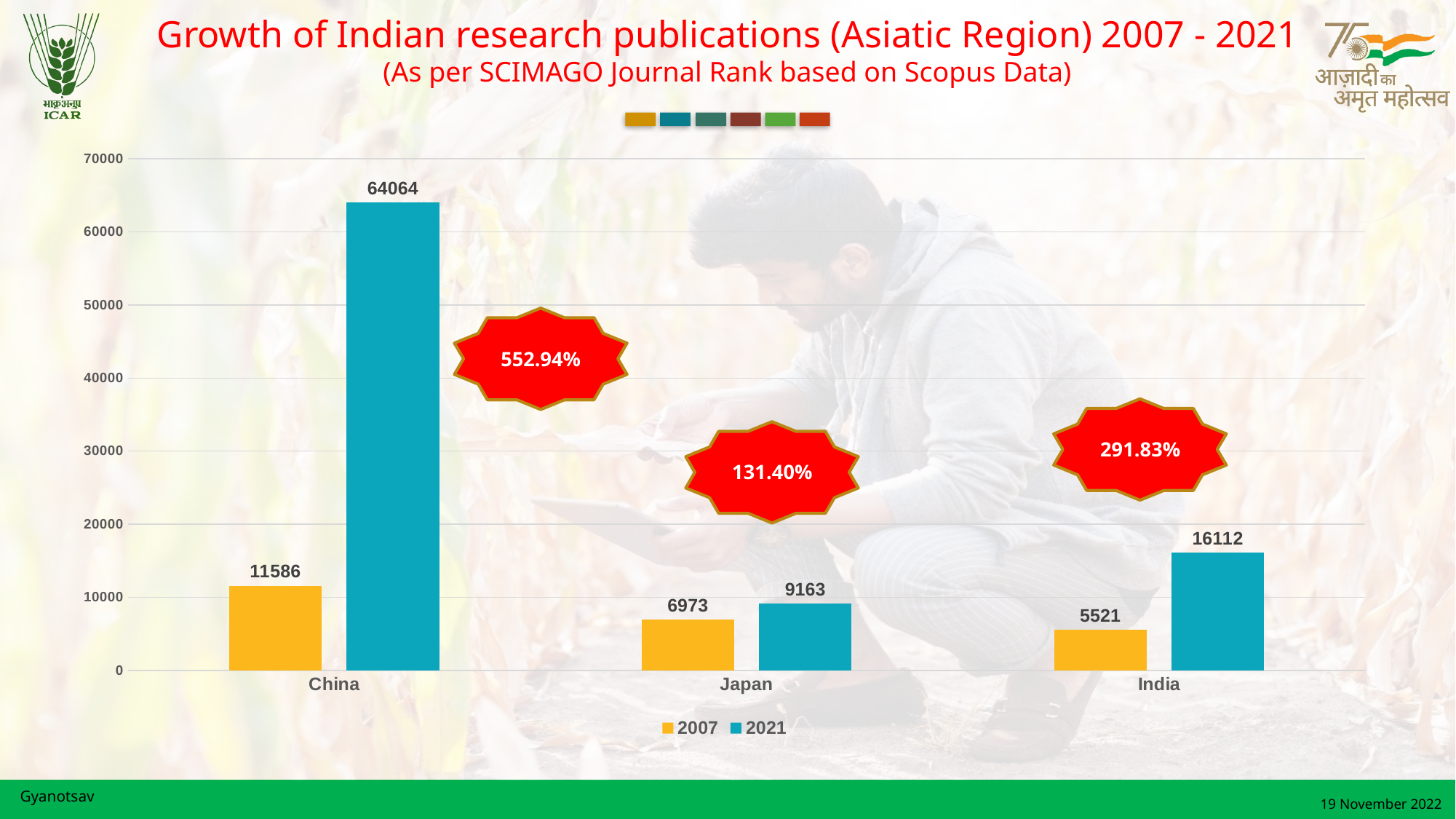
What is the value for India in 2007? 5521 Which country has the lowest value in 2007? India Which country has the highest value in 2021? China What is the value for Japan in 2021? 9163 What kind of chart is shown on the slide? Bar chart What growth percentage is shown in the red badge for India? 291.83% Which is larger: India's 2021 value or Japan's 2021 value? India's 2021 value What is the value for China in 2021? 64064 What is the difference between India's 2021 and 2007 values? 10591 What is the difference between China's 2007 value and Japan's 2007 value? 4613 How many series does the legend list? 2 How many countries are shown on the x axis? 3